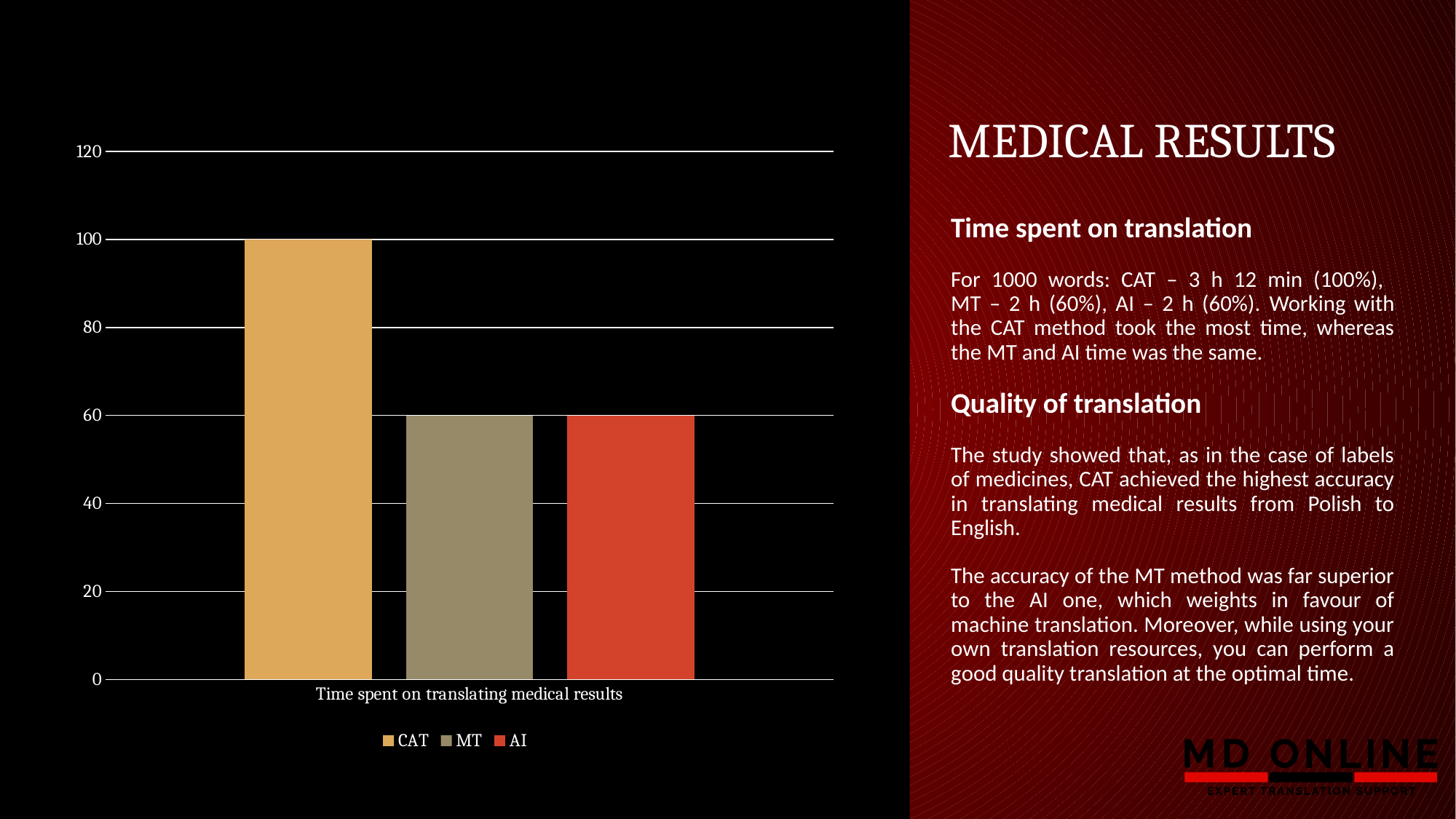
What is the highest value shown on the chart's vertical axis? 120 Which series has the highest bar in the chart? CAT Which is larger, the CAT bar or the AI bar? CAT What is the difference between the CAT bar and the MT bar? 40 What is the value of the CAT bar in the chart? 100 What is the value of the MT bar in the chart? 60 What is the value of the AI bar in the chart? 60 How many series does the chart legend list? 3 How many bars are plotted in the chart? 3 What kind of chart is shown on the slide? bar chart What is the category label shown on the x axis of the chart? Time spent on translating medical results Is the value for MT greater or less than 80? less